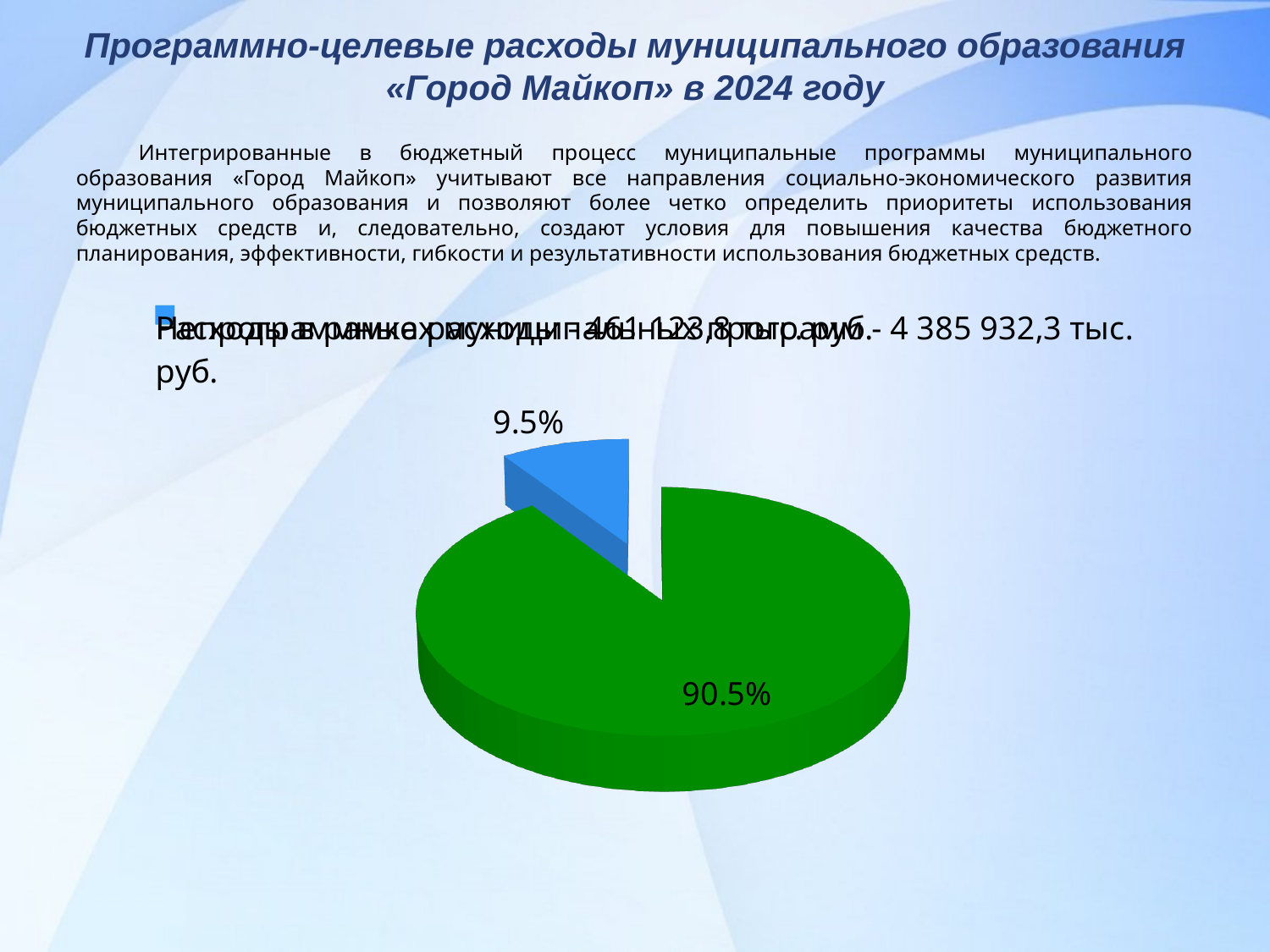
Is the share of the green slice greater or less than 90%? greater Which slice of the pie chart is the largest? the green slice (90.5%) Which slice is larger, the green one or the blue one? the green one What percentage is shown on the blue slice of the pie chart? 9.5% What colour is the largest slice of the pie chart? green What is the difference in percentage points between the green slice and the blue slice? 81 percentage points What kind of chart is shown on the slide? pie chart How many slices does the pie chart have? 2 Is the share of the blue slice greater or less than 10%? less What percentage is shown on the green slice of the pie chart? 90.5% Is the blue slice pulled out (exploded) from the rest of the pie? yes Which slice of the pie chart is the smallest? the blue slice (9.5%)